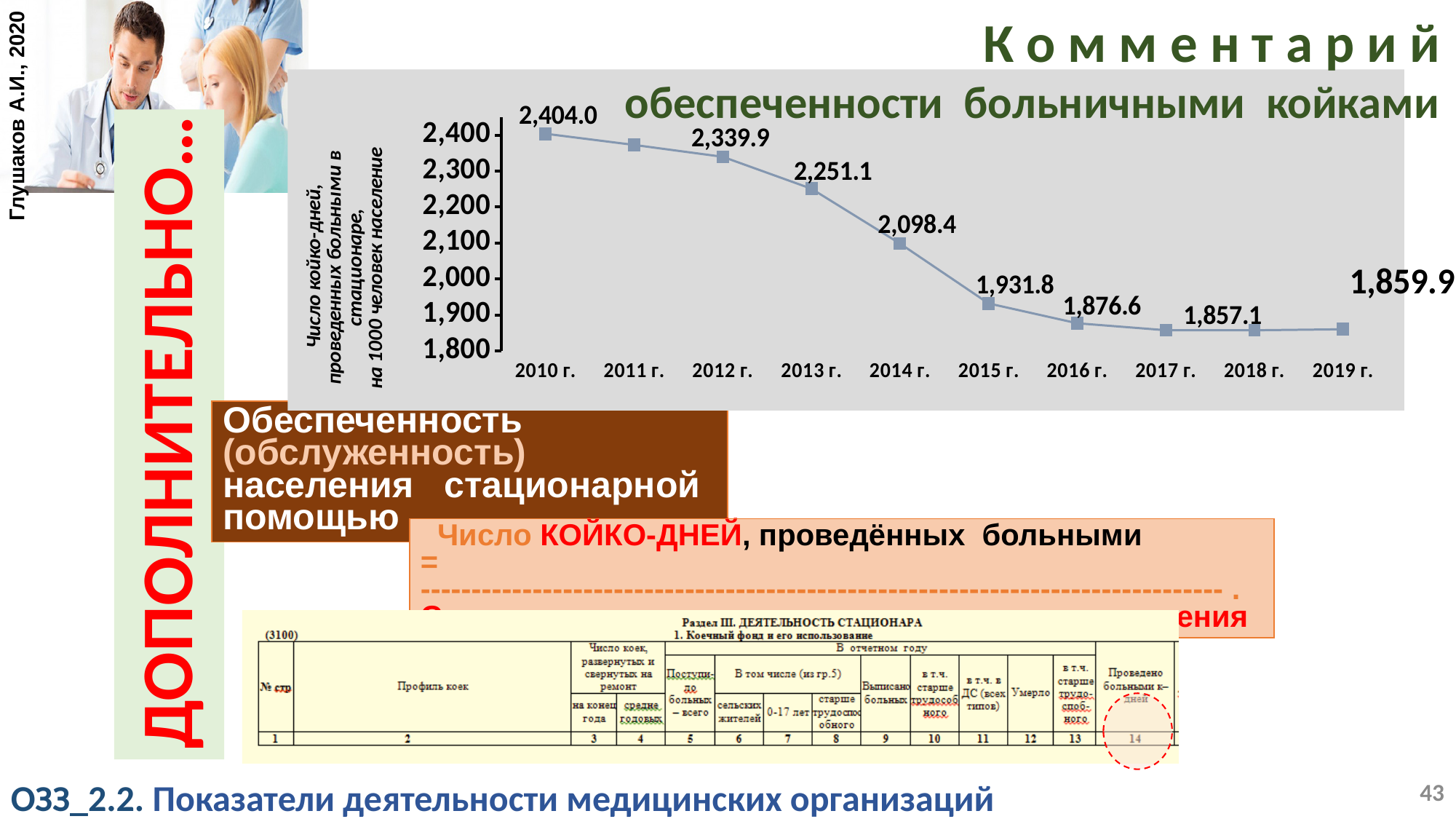
What is the difference between the values for 2013 г. and 2014 г.? 152.7 What is the difference between the values for 2010 г. and 2019 г.? 544.1 What type of chart is shown on the slide? line chart Which is larger, the value for 2012 г. or the value for 2015 г.? 2012 г. What is the value for 2014 г.? 2,098.4 How many years are plotted on the x axis? 10 What is the value for 2010 г.? 2,404.0 Which year has the highest value? 2010 г. Do the values rise or fall from 2010 г. to 2017 г.? fall What is the value for 2016 г.? 1,876.6 What is the value for 2019 г.? 1,859.9 Is the value for 2011 г. greater or less than 2,300? greater